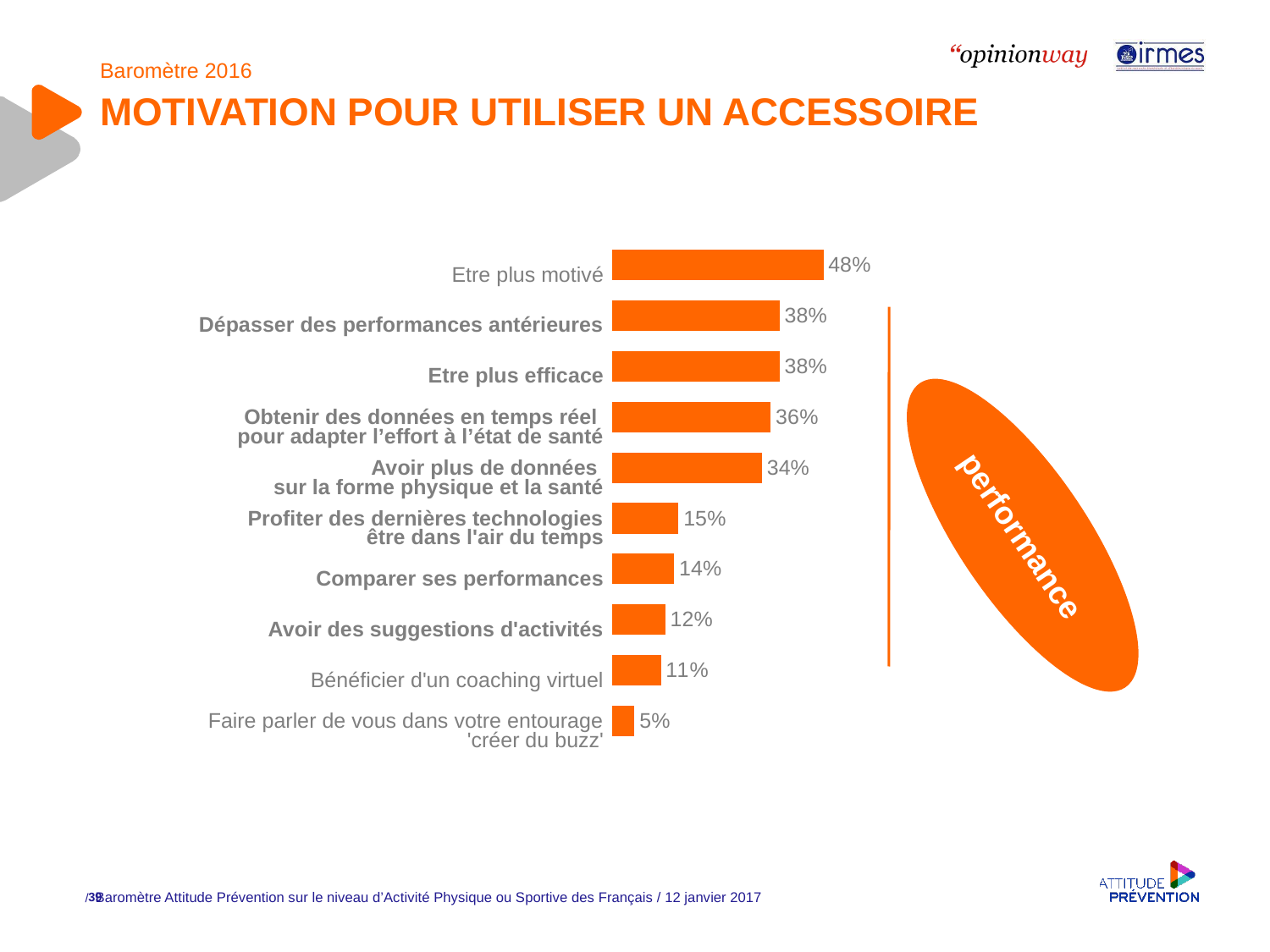
What is the value for "Comparer ses performances"? 14% Which category has the lowest value? Faire parler de vous dans votre entourage 'créer du buzz' Which is larger: "Profiter des dernières technologies être dans l'air du temps" or "Comparer ses performances"? Profiter des dernières technologies être dans l'air du temps What kind of chart is shown on the slide? Bar chart Which category has the highest value? Etre plus motivé What is the difference between "Etre plus motivé" and "Etre plus efficace"? 10 percentage points What is the difference between "Avoir plus de données sur la forme physique et la santé" and "Avoir des suggestions d'activités"? 22 percentage points What word is written in the orange oval next to the chart? performance How many categories are shown in the chart? 10 Which two categories share the value 38%? Dépasser des performances antérieures and Etre plus efficace What percentage is shown for "Bénéficier d'un coaching virtuel"? 11% What percentage is shown for "Etre plus motivé"? 48%